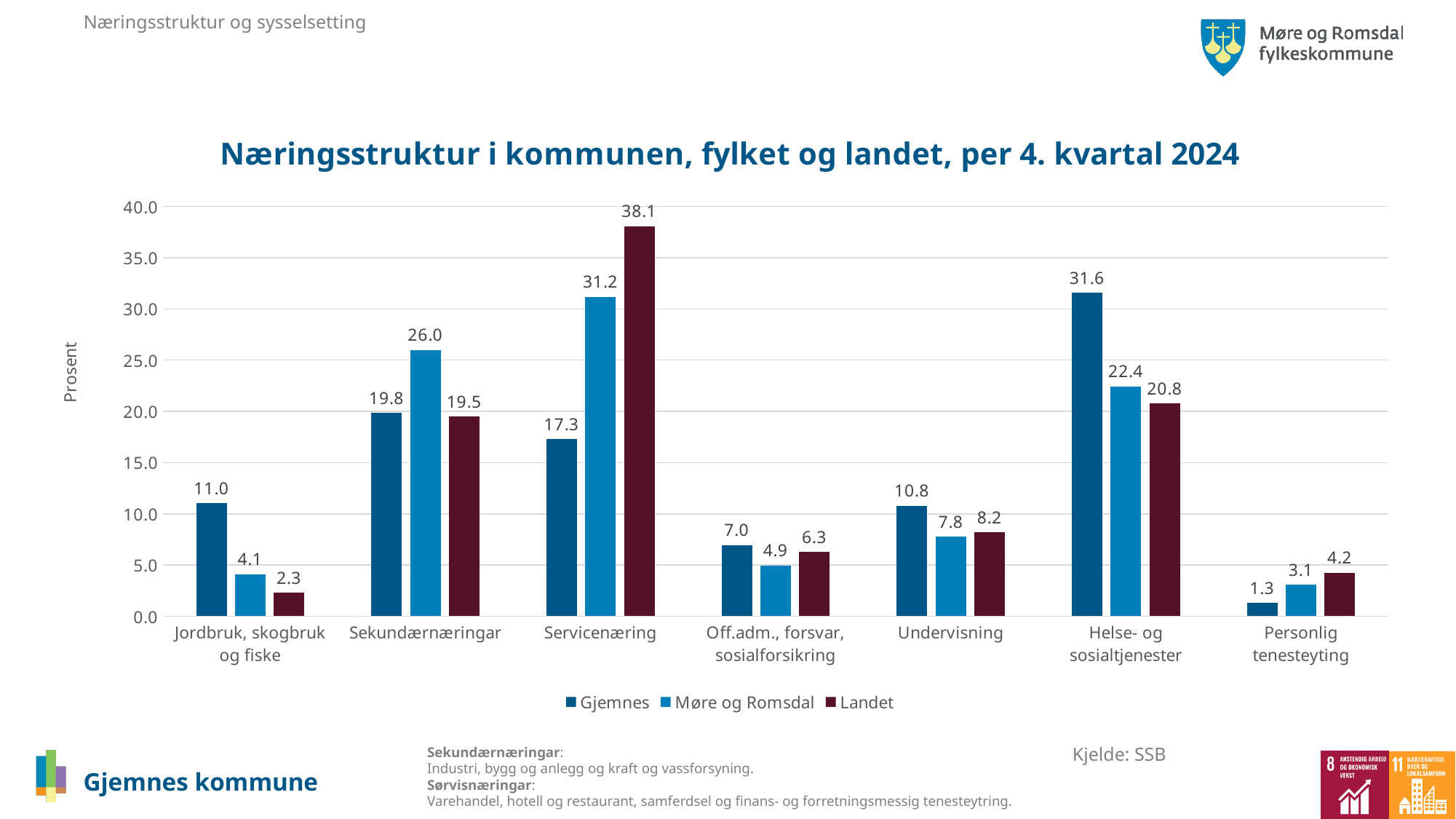
What is the value for Landet in the Helse- og sosialtjenester category? 20.8 What is the value for Gjemnes in the Servicenæring category? 17.3 Is the value for Møre og Romsdal in the Helse- og sosialtjenester category greater or less than 20.0? greater What kind of chart is shown on the slide? bar chart What is the label of the y axis? Prosent What is the difference between the Landet and Gjemnes values in the Servicenæring category? 20.8 What is the value for Møre og Romsdal in the Sekundærnæringar category? 26.0 Which category has the lowest value for Gjemnes? Personlig tenesteyting In the Undervisning category, which is larger: the value for Gjemnes or the value for Landet? Gjemnes How many categories are shown on the x axis? 7 How many series does the legend list? 3 Which category has the highest value for Landet? Servicenæring